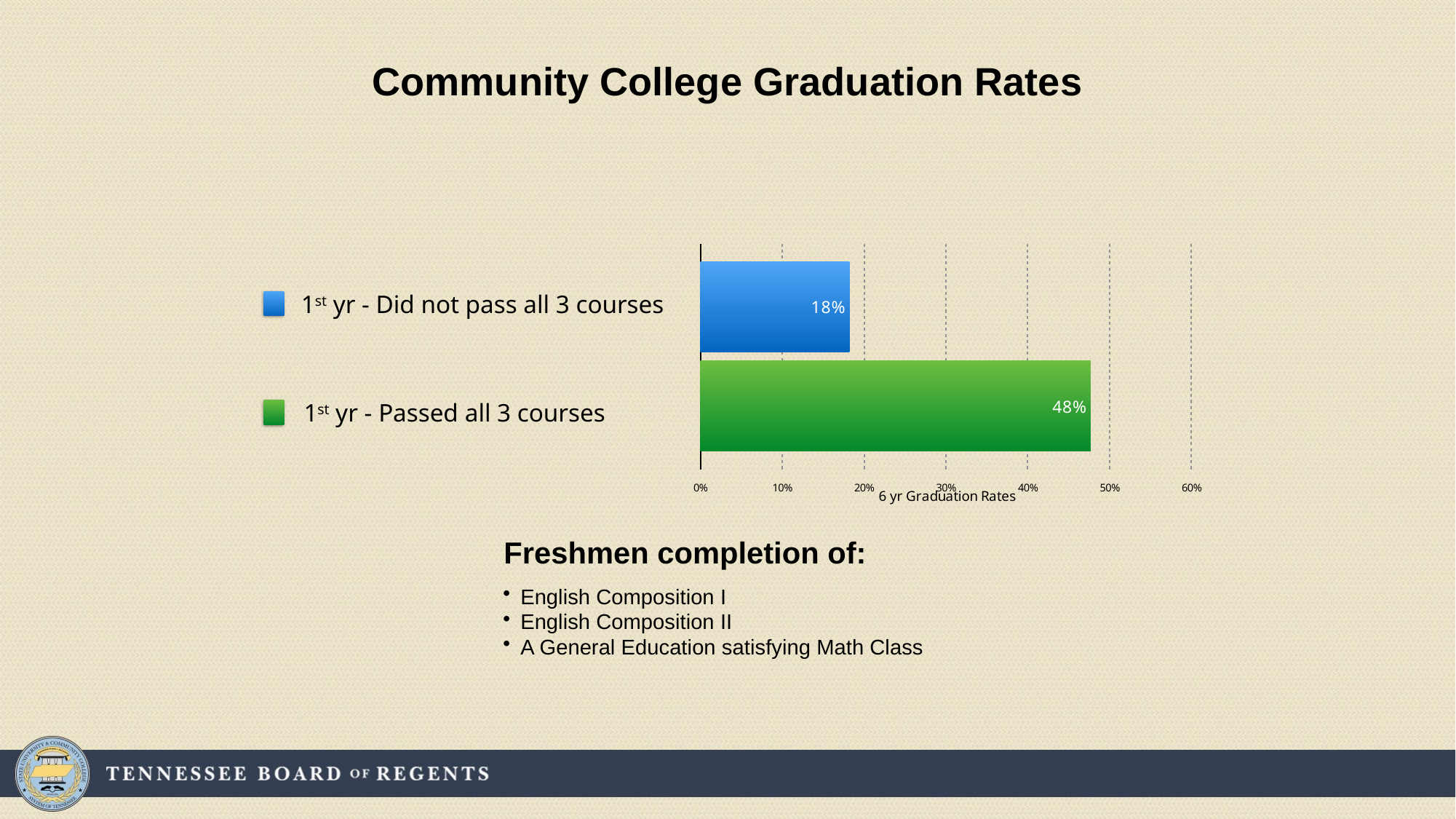
Which group has the higher 6 yr graduation rate? 1st yr - Passed all 3 courses What colour is the bar for students who passed all 3 courses? Green What is the 6 yr graduation rate for students who passed all 3 courses in their 1st year? 48% What is the label on the horizontal axis of the chart? 6 yr Graduation Rates What type of chart is shown on the slide? Bar chart Which group has the lower 6 yr graduation rate? 1st yr - Did not pass all 3 courses Is the graduation rate for students who passed all 3 courses greater or less than 40%? greater What is the 6 yr graduation rate for students who did not pass all 3 courses in their 1st year? 18% What is the difference in 6 yr graduation rate between students who passed all 3 courses and those who did not? 30% How many bars are plotted in the chart? 2 What is the highest value shown on the horizontal axis? 60% Is the graduation rate for students who did not pass all 3 courses greater or less than 20%? less